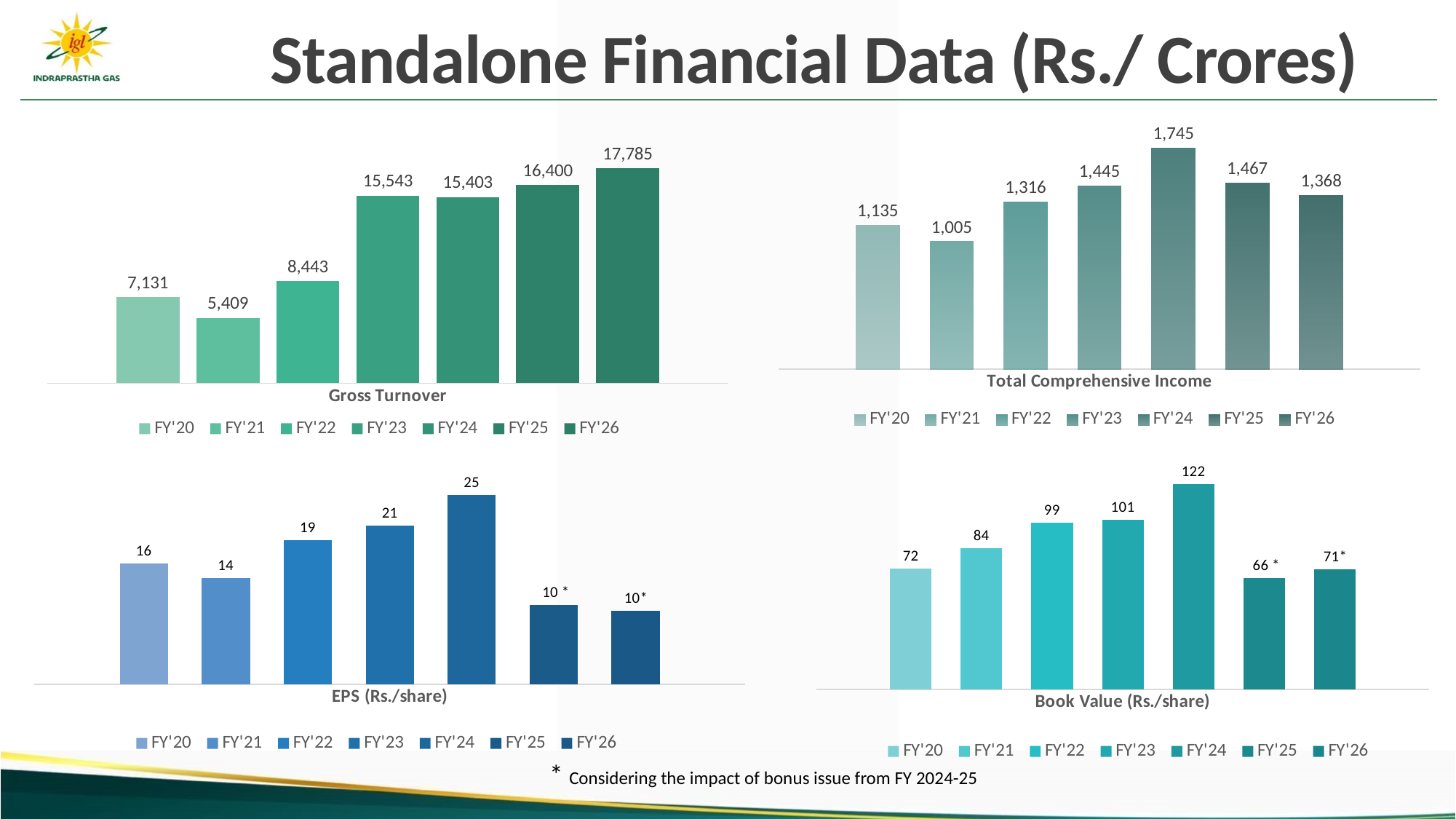
In the Gross Turnover chart, which fiscal year has the lowest value? FY'21 What type of chart is the EPS (Rs./share) chart? Bar chart In the Book Value (Rs./share) chart, what is the value for FY'20? 72 In the Gross Turnover chart, what is the value for FY'26? 17,785 In the Total Comprehensive Income chart, which is larger, FY'25 or FY'26? FY'25 In the Book Value (Rs./share) chart, which fiscal year has the highest value? FY'24 In the Total Comprehensive Income chart, which fiscal year has the highest value? FY'24 In the Total Comprehensive Income chart, what is the value for FY'21? 1,005 In the EPS (Rs./share) chart, what is the value for FY'24? 25 How many fiscal years are plotted in the Book Value (Rs./share) chart? 7 In the EPS (Rs./share) chart, what is the difference between FY'24 and FY'23? 4 In the Gross Turnover chart, what is the difference between FY'23 and FY'22? 7,100